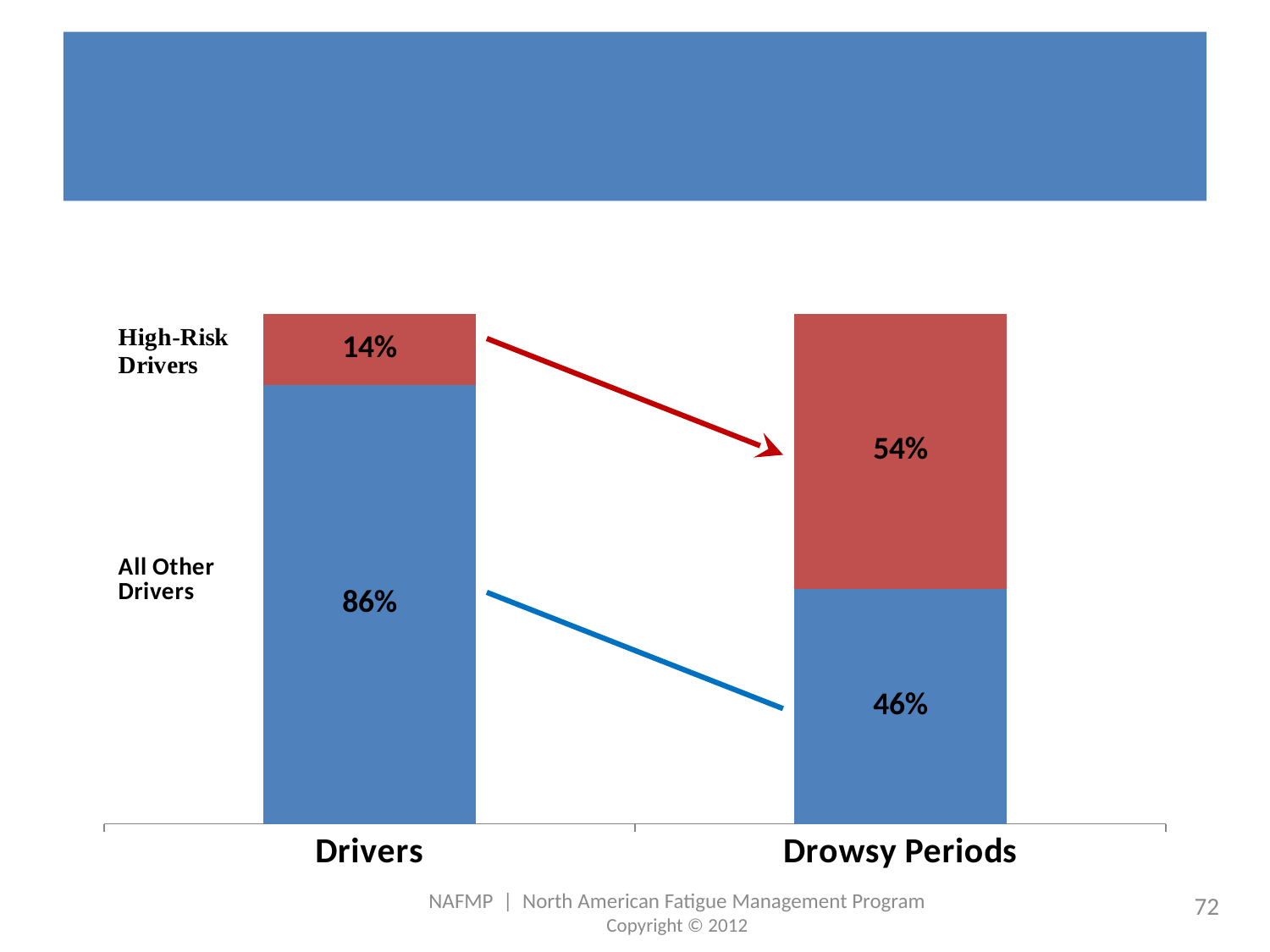
Which category has the larger High-Risk Drivers share, Drivers or Drowsy Periods? Drowsy Periods What share of Drowsy Periods is attributed to All Other Drivers? 46% What percentage of Drivers are All Other Drivers? 86% What share of Drowsy Periods is attributed to High-Risk Drivers? 54% How many categories are shown on the x axis? 2 Which category has the larger All Other Drivers share, Drivers or Drowsy Periods? Drivers What is the total of the Drowsy Periods stacked bar? 100% Which colour represents High-Risk Drivers in the chart? Red What percentage of Drivers are High-Risk Drivers? 14% What is the difference between the All Other Drivers share and the High-Risk Drivers share in the Drivers bar? 72% What kind of chart is shown on the slide? Stacked bar chart What is the difference between the High-Risk Drivers share of Drowsy Periods and the High-Risk Drivers share of Drivers? 40%